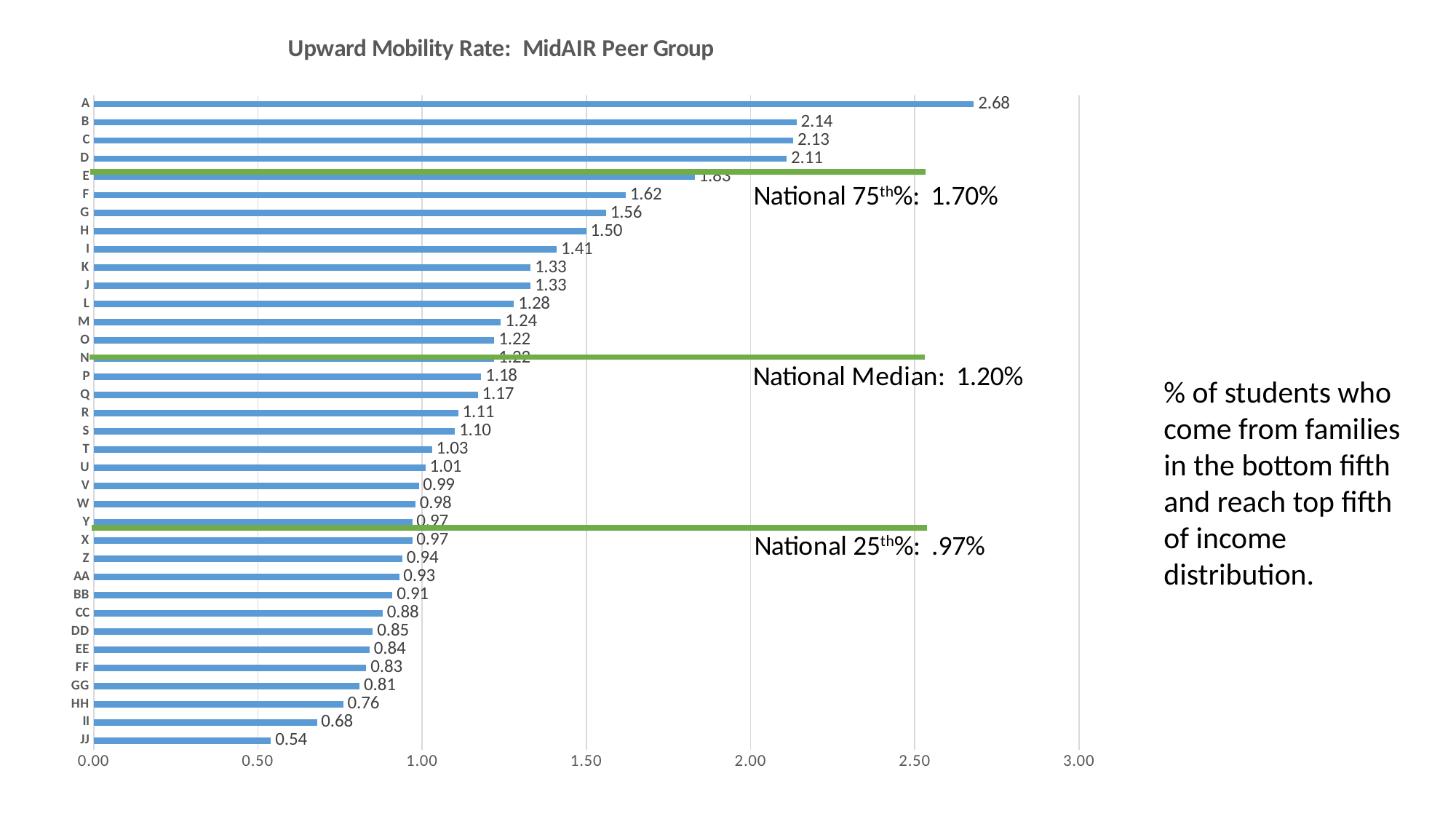
What is the value for HH? 0.76 Which is larger, the value for F or the value for G? F Which category has the highest upward mobility rate? A Do the bar values increase or decrease going from A at the top to JJ at the bottom? decrease What is the value for JJ? 0.54 What National Median value is annotated on the chart? 1.20% How many categories are plotted in the chart? 36 What is the value for A? 2.68 Which category has the lowest upward mobility rate? JJ Is the value for D greater or less than 2.00? greater What kind of chart is shown on the slide? Bar chart What is the difference between the values for A and B? 0.54